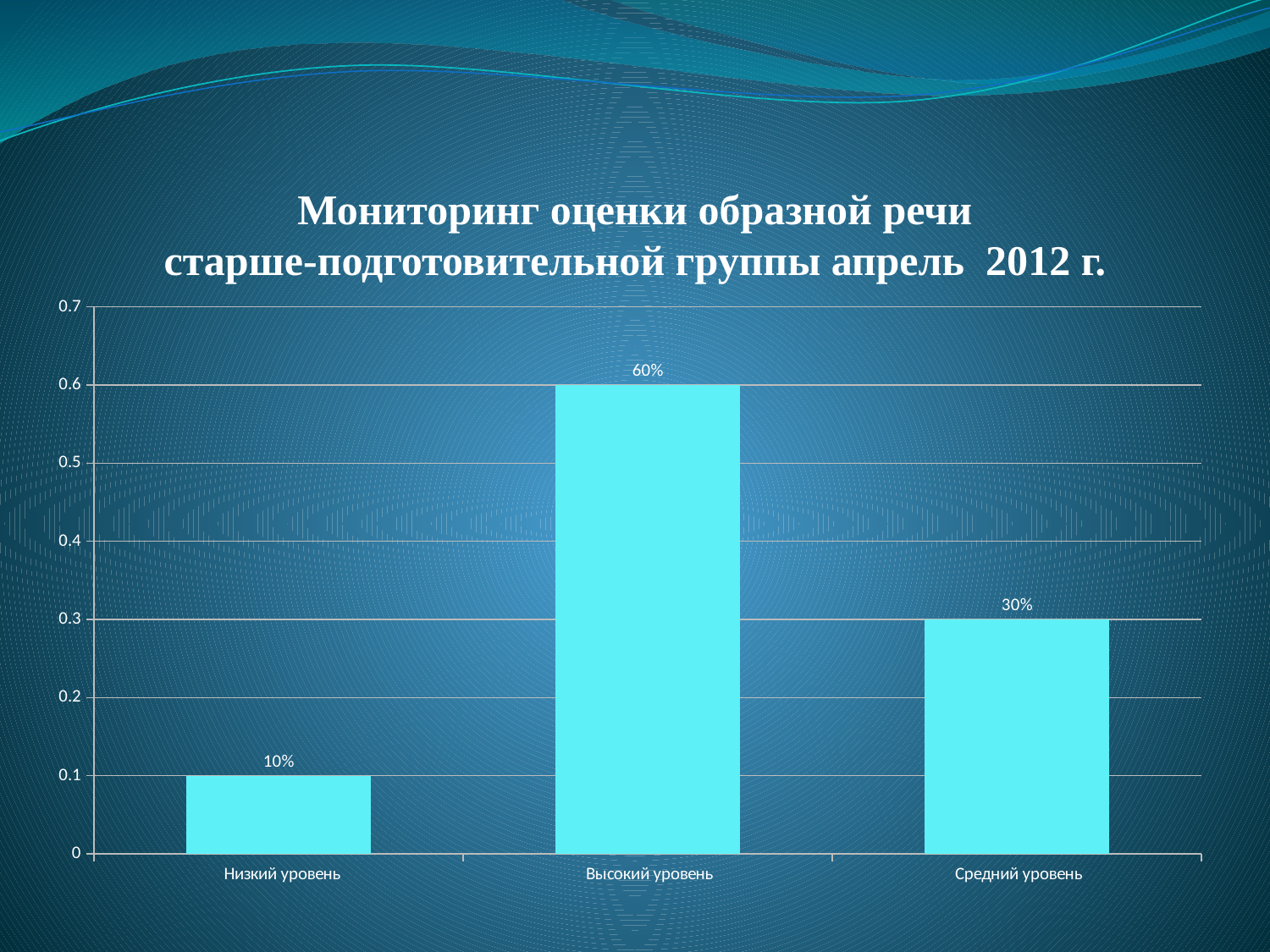
Which category has the lowest value? Низкий уровень Is the value for Высокий уровень greater or less than 0.5? greater What is the difference between the values for Высокий уровень and Средний уровень? 30% What is the highest value shown on the vertical axis? 0.7 What is the difference between the values for Средний уровень and Низкий уровень? 20% Which is larger, the value for Средний уровень or the value for Низкий уровень? Средний уровень What kind of chart is shown on the slide? bar chart What is the value for Низкий уровень? 10% How many categories are shown on the x axis? 3 What is the value for Средний уровень? 30% What is the value for Высокий уровень? 60% Which category has the highest value? Высокий уровень